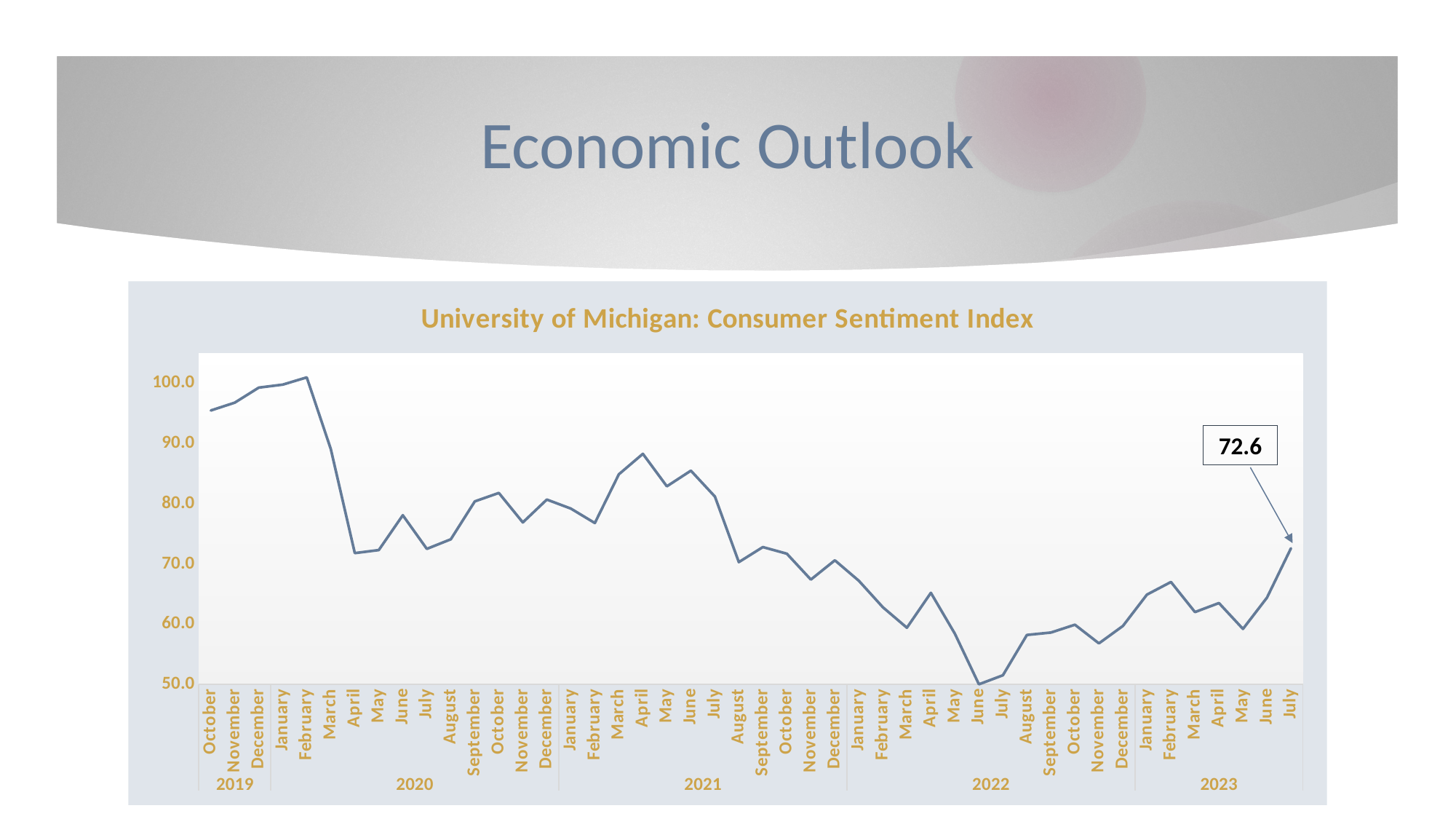
Is the value for October 2019 greater or less than 90.0? greater How many monthly data points are plotted on the chart? 46 In which month is the Consumer Sentiment Index at its lowest? June 2022 Which is larger, the value for June 2022 or the value for July 2023? July 2023 What type of chart is shown on the slide? line chart Does the Consumer Sentiment Index rise or fall from October 2019 to February 2020? rise In which month is the Consumer Sentiment Index at its highest? February 2020 Is the value for April 2021 greater or less than 80.0? greater Which is larger, the value for February 2020 or the value for April 2020? February 2020 What is the title of the chart? University of Michigan: Consumer Sentiment Index Is the value for April 2020 greater or less than 80.0? less What is the value of the Consumer Sentiment Index for July 2023? 72.6